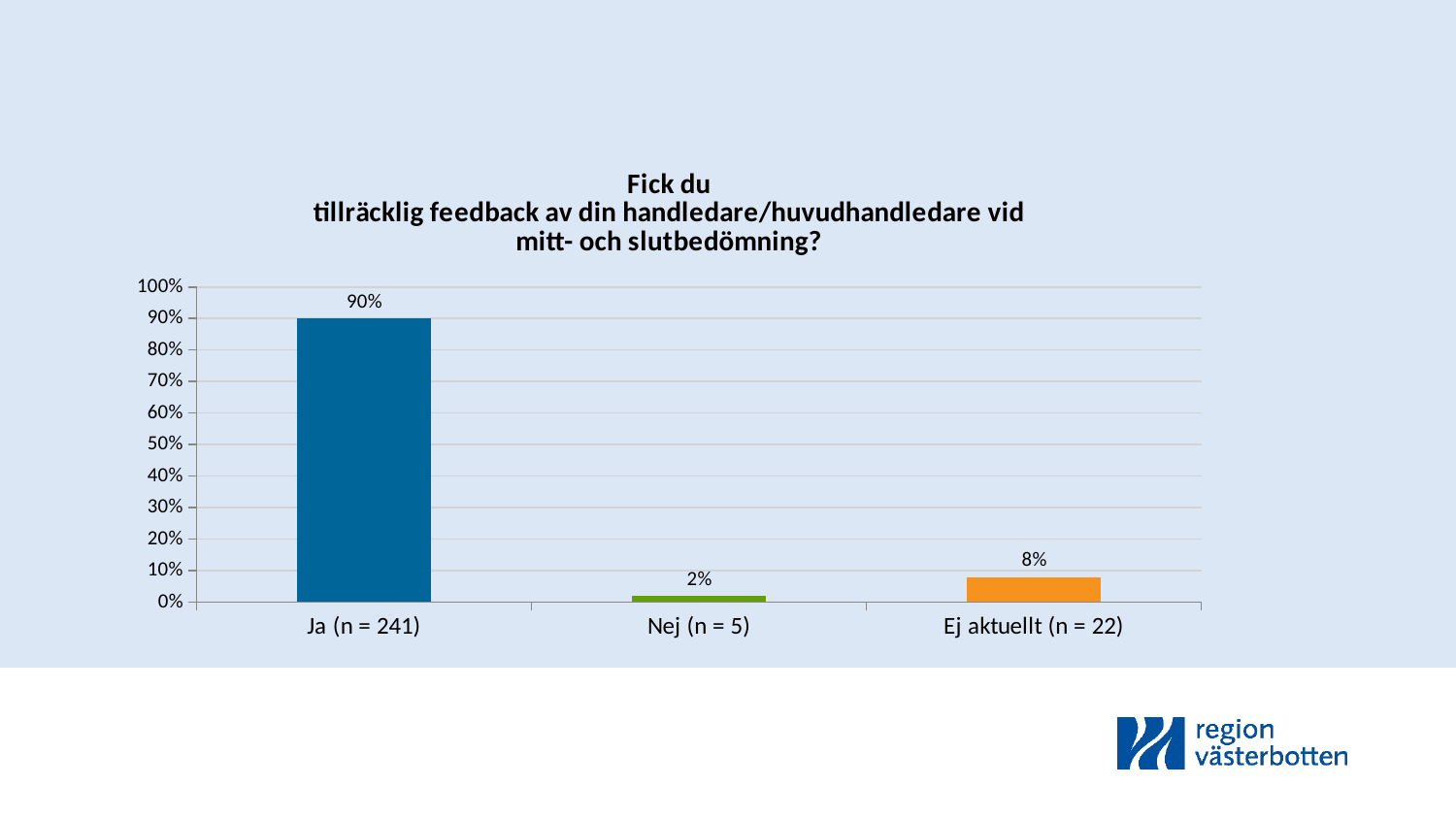
What is the value for Ja (n = 241)? 90% Which category has the highest value? Ja (n = 241) What is the difference between the values for Ja (n = 241) and Ej aktuellt (n = 22)? 82% What colour is the bar for Ej aktuellt (n = 22)? orange What kind of chart is shown on the slide? bar chart What is the value for Nej (n = 5)? 2% Which category has the lowest value? Nej (n = 5) Is the value for Ja (n = 241) greater or less than 50%? greater Which is larger, the value for Nej (n = 5) or the value for Ej aktuellt (n = 22)? Ej aktuellt (n = 22) How many categories are shown on the x axis? 3 What is the difference between the values for Ej aktuellt (n = 22) and Nej (n = 5)? 6% What is the value for Ej aktuellt (n = 22)? 8%